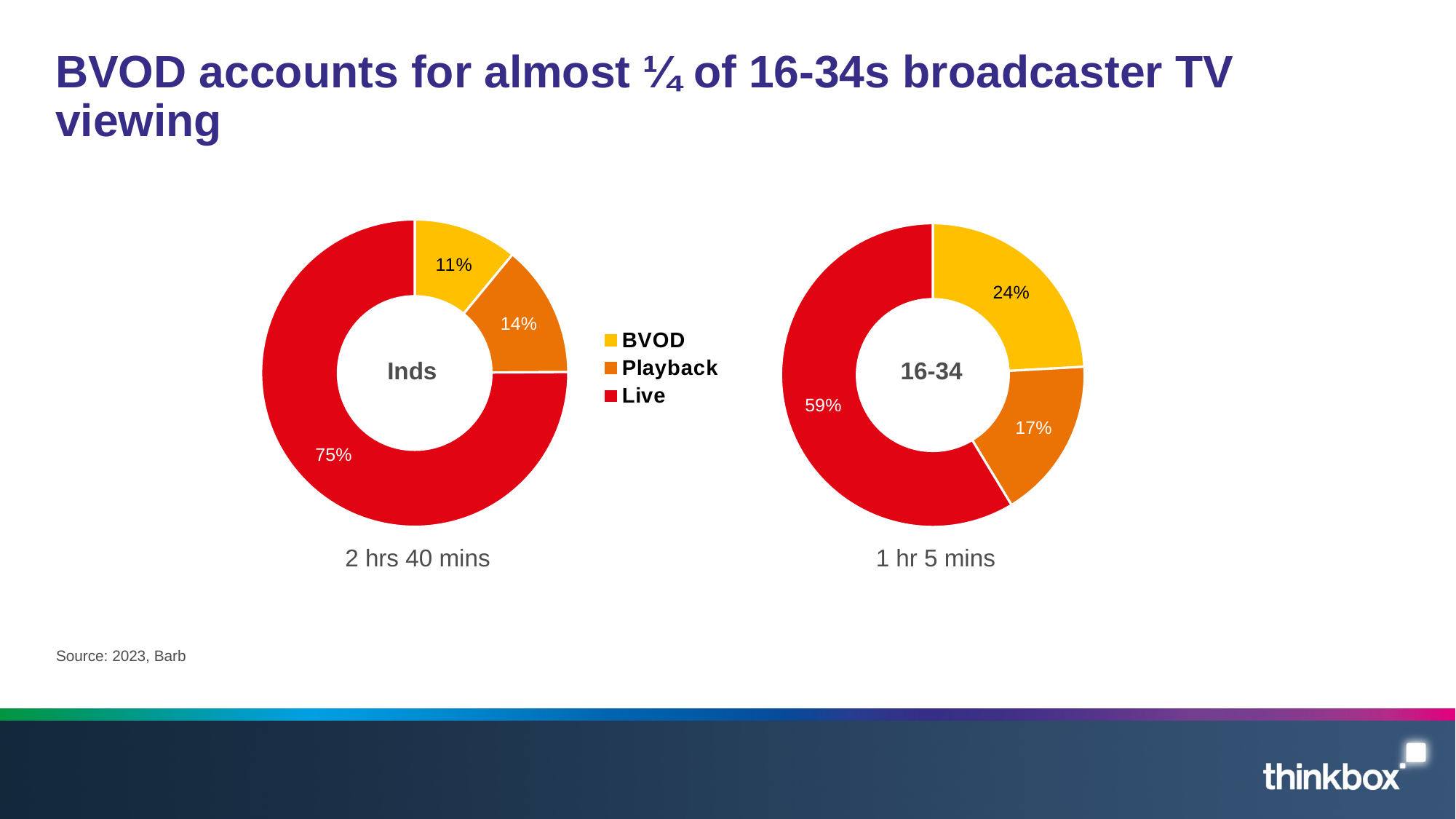
In the Inds chart, which category has the largest share? Live Which colour represents Playback in the legend? Orange In the 16-34 chart, what share of viewing is Live? 59% In the Inds chart, what share of viewing is BVOD? 11% In the 16-34 chart, what share of viewing is Playback? 17% What total viewing time is shown beneath the Inds chart? 2 hrs 40 mins What is the difference between the BVOD share in the 16-34 chart and the BVOD share in the Inds chart? 13 percentage points What kind of chart is used on this slide? Doughnut (pie) chart In the Inds chart, what share of viewing is Playback? 14% In the 16-34 chart, which category has the smallest share? Playback How many series does the legend list? 3 Which is larger: the Live share in the Inds chart or the Live share in the 16-34 chart? Inds